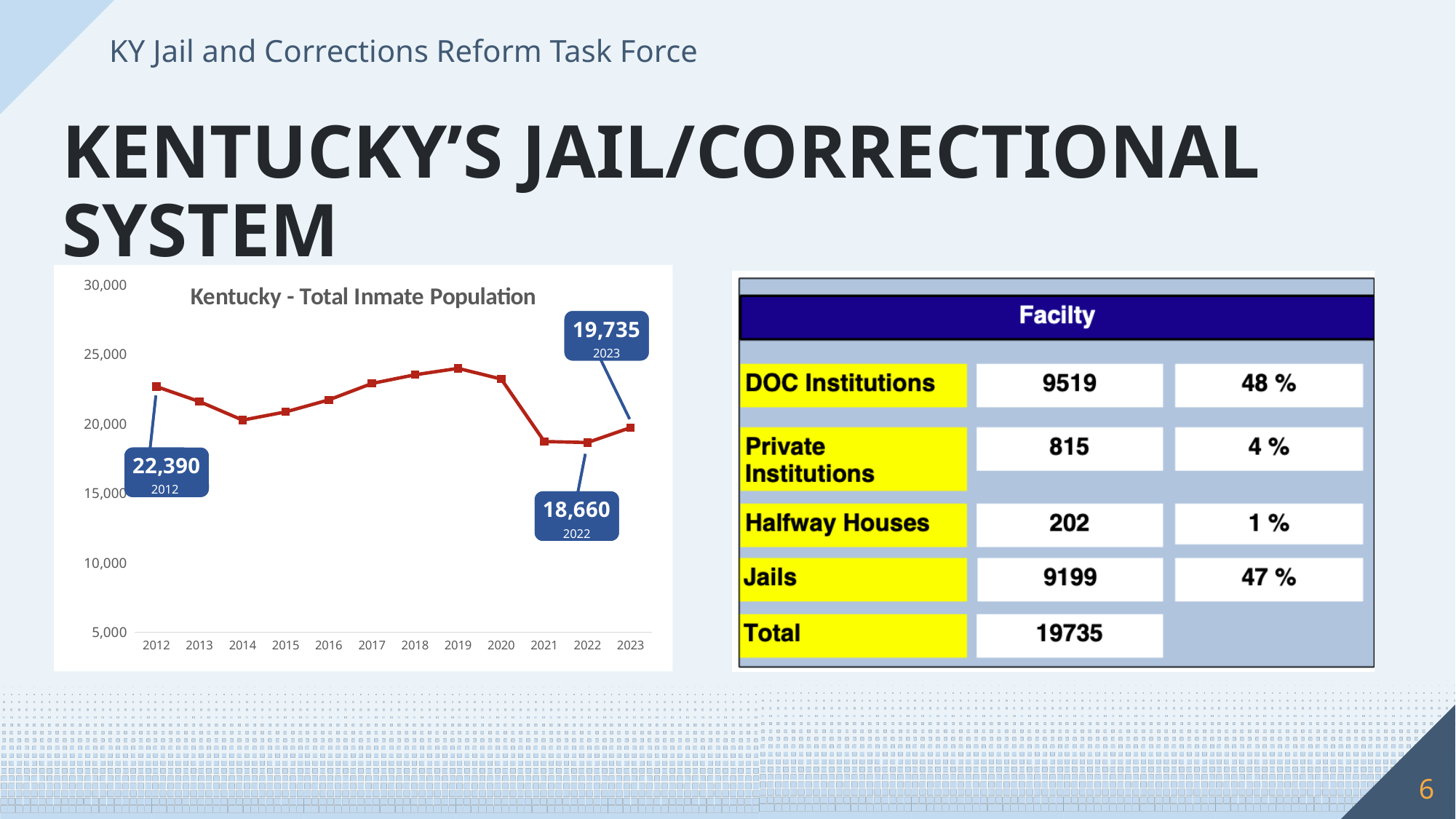
How many years are plotted on the x axis of the inmate population chart? 12 Which year had a larger inmate population, 2012 or 2023? 2012 What was Kentucky's total inmate population in 2023 according to the chart? 19,735 By how much did the total inmate population increase from 2022 to 2023? 1,075 What was Kentucky's total inmate population in 2022 according to the chart? 18,660 What was Kentucky's total inmate population in 2012 according to the chart? 22,390 Is the inmate population value for 2021 greater or less than 20,000? less In which year does the inmate population chart reach its highest value? 2019 Does the inmate population rise or fall between 2019 and 2021? fall What is the difference between the 2012 and 2023 inmate population values? 2,655 What is the title of the chart on the slide? Kentucky - Total Inmate Population What kind of chart is used to show Kentucky's total inmate population? line chart